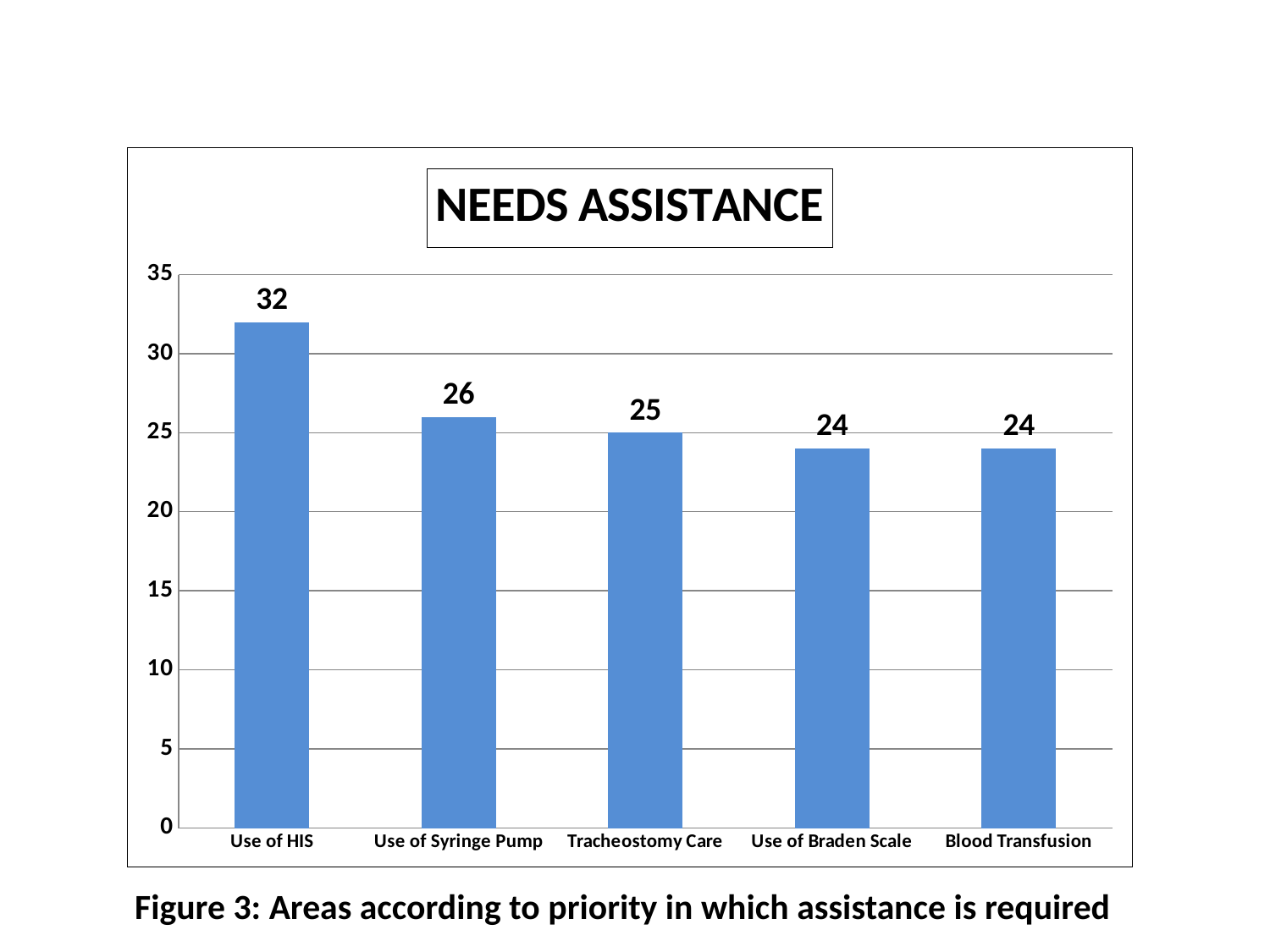
What is the value for Use of Syringe Pump? 26 Is the value for Use of HIS greater or less than 30? greater Which category has the highest value? Use of HIS How many categories are shown on the x axis? 5 What is the value for Tracheostomy Care? 25 What is the difference between the values for Use of HIS and Use of Syringe Pump? 6 What is the difference between the values for Use of HIS and Use of Braden Scale? 8 What is the value for Use of HIS? 32 Which is larger, the value for Use of Syringe Pump or the value for Tracheostomy Care? Use of Syringe Pump What is the value for Blood Transfusion? 24 What kind of chart is shown on the slide? Bar chart What is the title of the chart? NEEDS ASSISTANCE